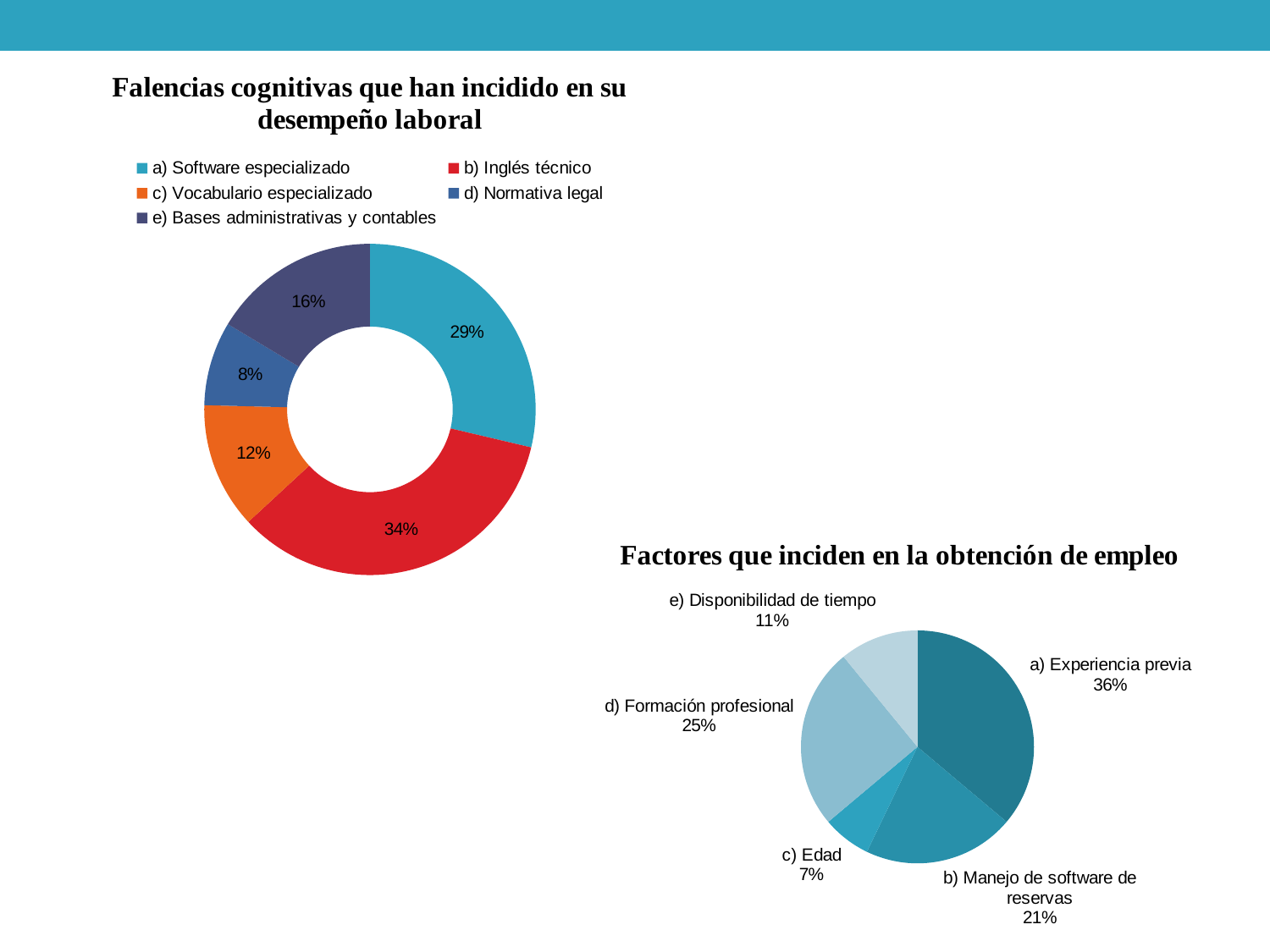
What kind of chart is the chart titled 'Factores que inciden en la obtención de empleo'? Pie chart In the chart titled 'Falencias cognitivas que han incidido en su desempeño laboral', what share does 'b) Inglés técnico' have? 34% In the chart titled 'Factores que inciden en la obtención de empleo', which is larger: 'd) Formación profesional' or 'b) Manejo de software de reservas'? d) Formación profesional In the chart titled 'Factores que inciden en la obtención de empleo', what is the difference between 'a) Experiencia previa' and 'e) Disponibilidad de tiempo'? 25% How many categories does the legend of the chart titled 'Falencias cognitivas que han incidido en su desempeño laboral' list? 5 In the chart titled 'Falencias cognitivas que han incidido en su desempeño laboral', what is the value for 'd) Normativa legal'? 8% What kind of chart is the chart titled 'Falencias cognitivas que han incidido en su desempeño laboral'? Doughnut chart In the chart titled 'Falencias cognitivas que han incidido en su desempeño laboral', what is the difference between 'a) Software especializado' and 'c) Vocabulario especializado'? 17% In the chart titled 'Falencias cognitivas que han incidido en su desempeño laboral', which category has the smallest share? d) Normativa legal In the chart titled 'Factores que inciden en la obtención de empleo', what is the value for 'c) Edad'? 7% In the chart titled 'Factores que inciden en la obtención de empleo', what share does 'a) Experiencia previa' have? 36% In the chart titled 'Falencias cognitivas que han incidido en su desempeño laboral', which category has the largest share? b) Inglés técnico